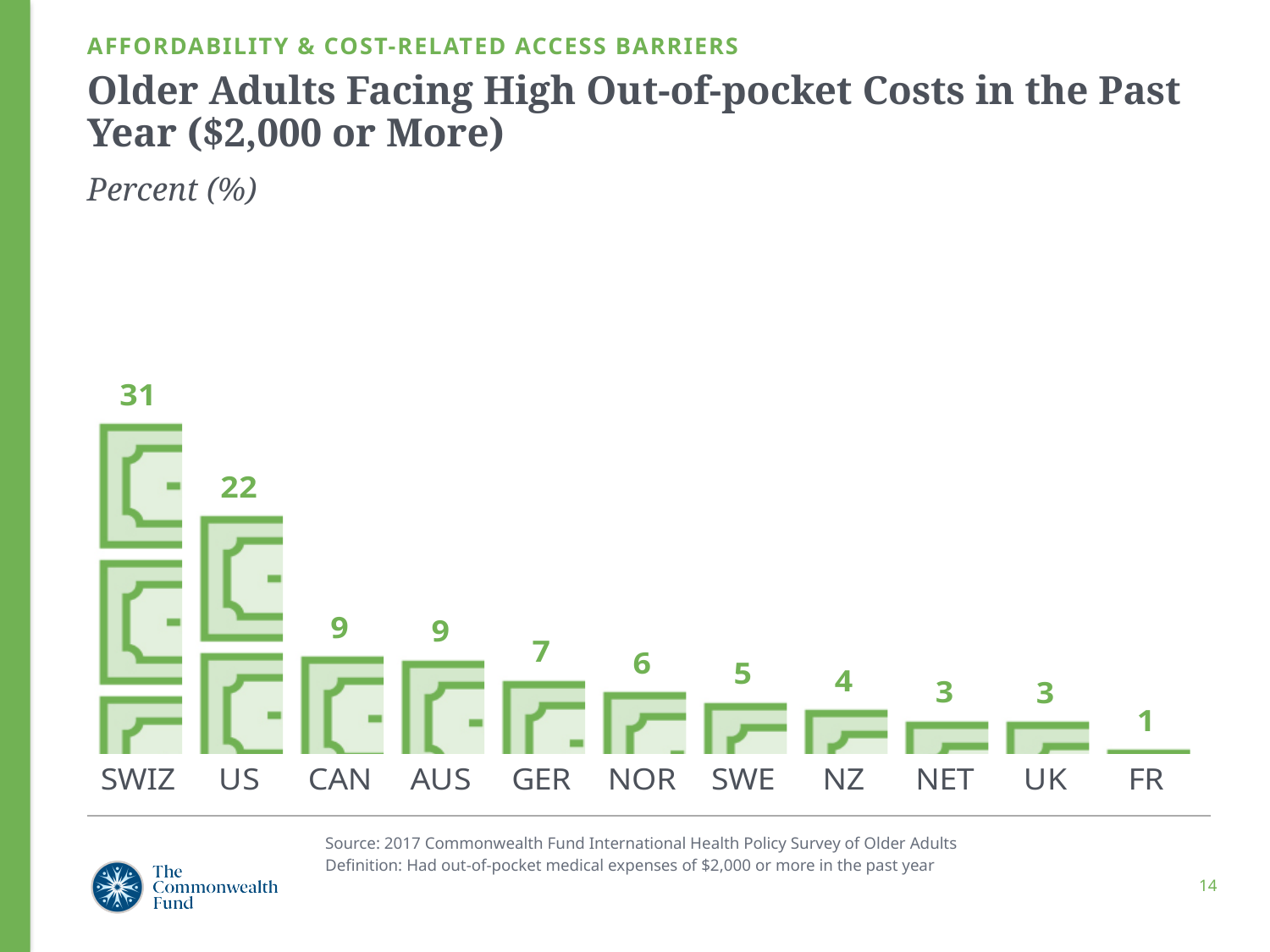
What is the difference between the values for CAN and NOR? 3 Which country has the highest value? SWIZ What kind of chart is this? Bar chart What is the value for NZ? 4 Which country has the lowest value? FR What is the difference between the values for SWIZ and the US? 9 What is the value for the US? 22 What is the value for GER? 7 Which is larger, the value for SWE or the value for NET? SWE What is the value for SWIZ? 31 How many countries are shown in the chart? 11 Do the values rise or fall from left to right across the chart? Fall